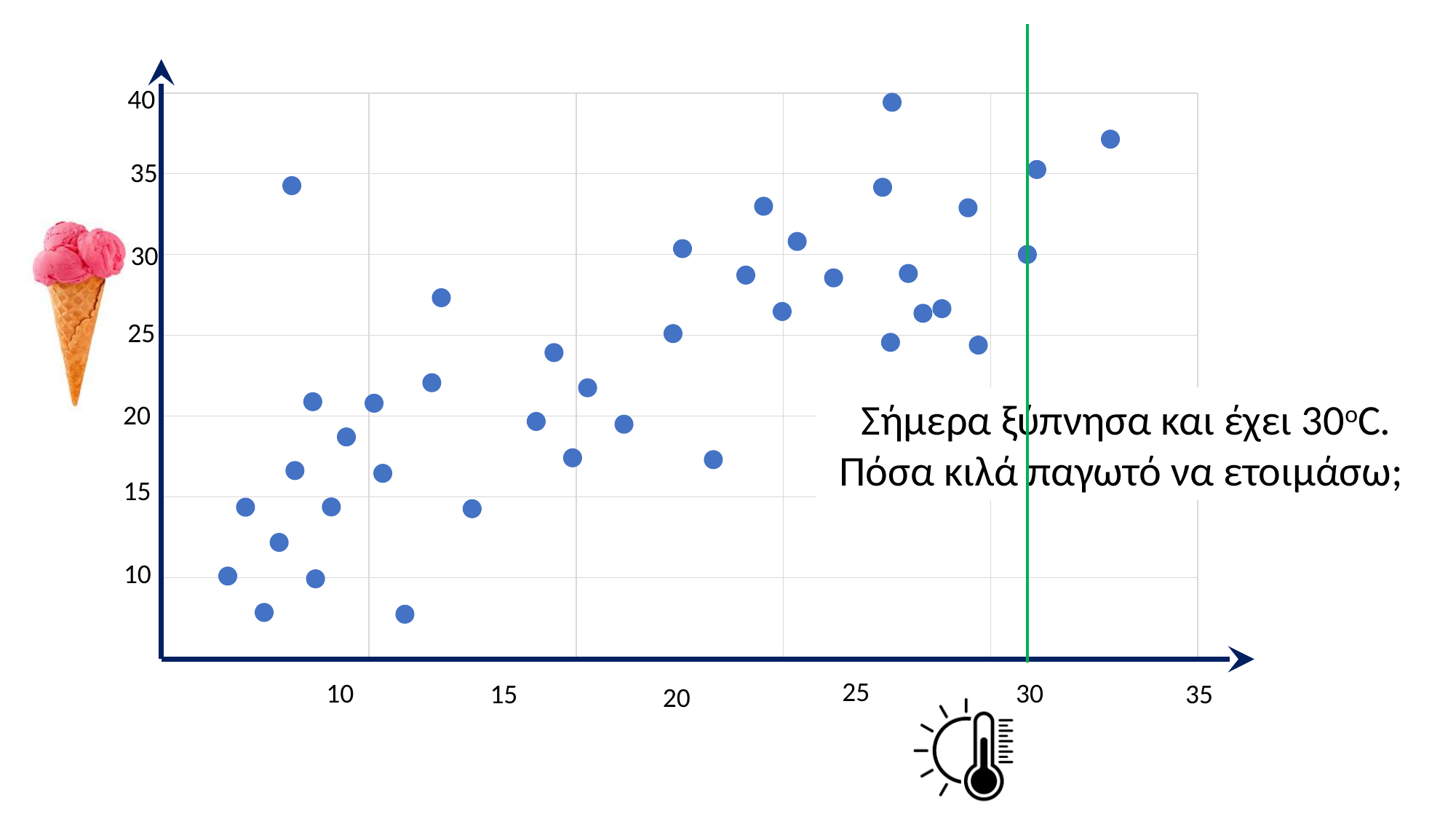
Is the y value of the rightmost plotted point greater or less than 35? greater At which x-axis value is the green vertical line drawn? 30 What kind of chart is shown on the slide? scatter plot What is the highest value labelled on the y axis? 40 Do the plotted values generally rise or fall as the x-axis value increases? rise Is the y value of the leftmost plotted point greater or less than 15? less Is the y value of the highest plotted point greater or less than 35? greater